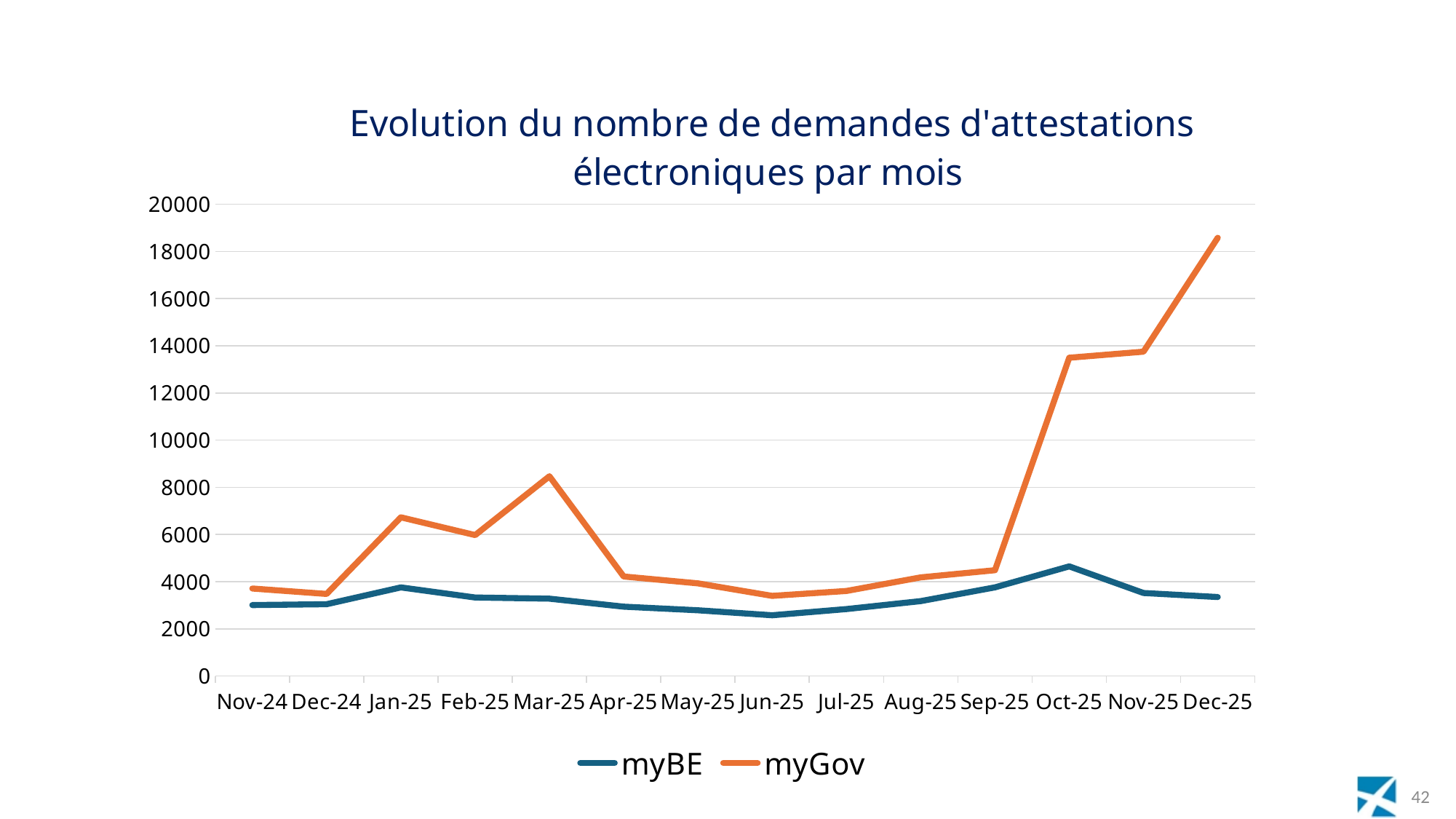
How many months are plotted along the x axis? 14 How many series does the legend list? 2 Is the value for myGov in Oct-25 greater or less than 12000? greater What is the title of the chart? Evolution du nombre de demandes d'attestations électroniques par mois Is the value for myBE in Jun-25 greater or less than 4000? less Is the value for myGov in Jan-25 greater or less than 6000? greater Does the myGov series rise or fall from Sep-25 to Dec-25? rise Which series has the larger value in Dec-25, myBE or myGov? myGov What kind of chart is shown on the slide? line chart In which month does the myGov series reach its highest value? Dec-25 In which month does the myBE series reach its lowest value? Jun-25